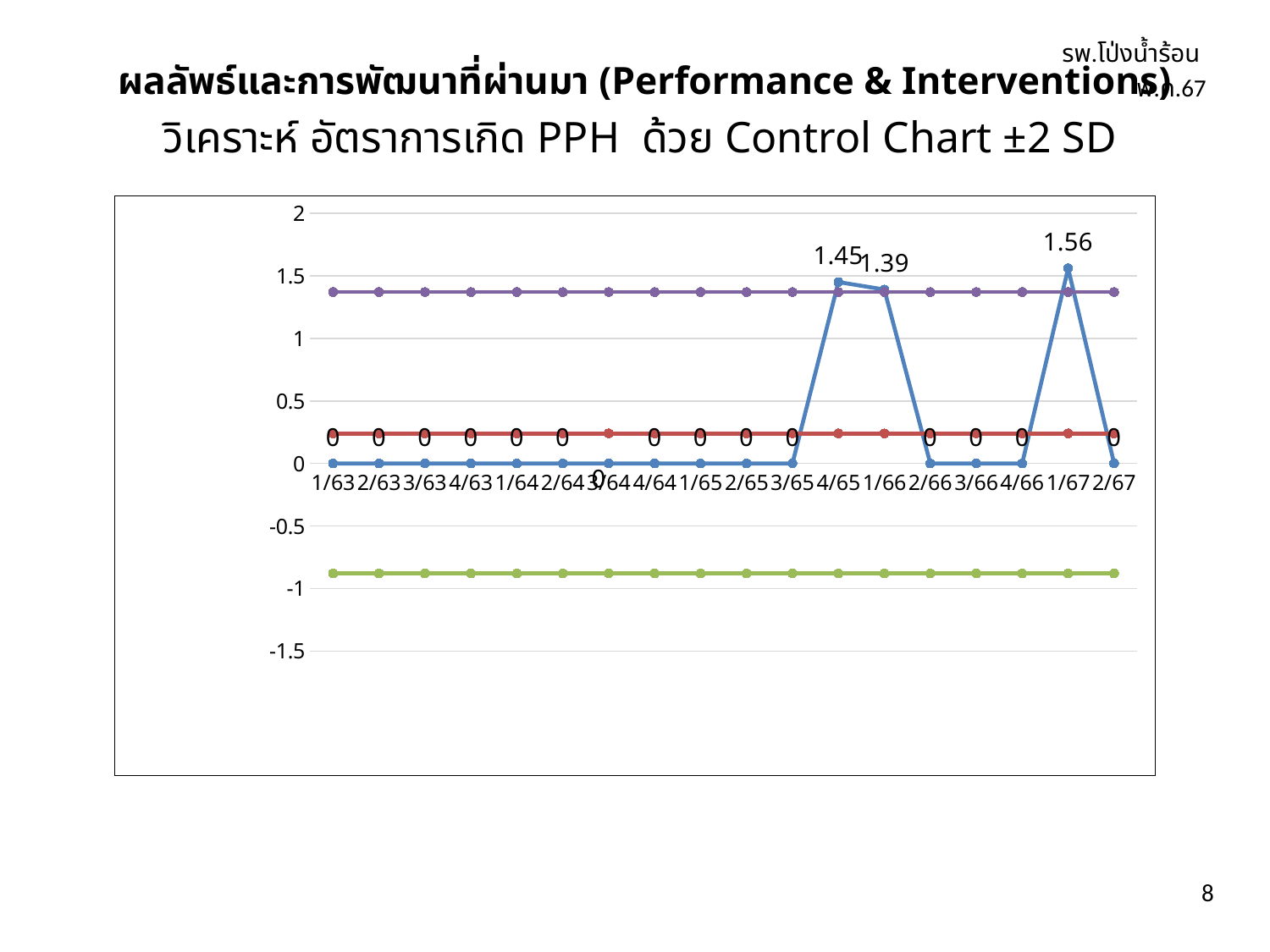
What kind of chart is shown on the slide? Line chart What is the PPH rate value plotted for 1/66? 1.39 How many periods are shown on the x axis of the chart? 18 What is the difference between the PPH rate at 4/65 and at 1/66? 0.06 Is the value of the purple upper control line greater or less than 1? greater What is the PPH rate value plotted for 2/67? 0 What is the difference between the PPH rate at 1/67 and at 4/65? 0.11 Which period has the larger PPH rate, 4/65 or 1/66? 4/65 How many lines are plotted on the chart? 4 Which period has the highest PPH rate on the chart? 1/67 What is the PPH rate value plotted for 4/65? 1.45 What is the PPH rate value plotted for 1/67? 1.56